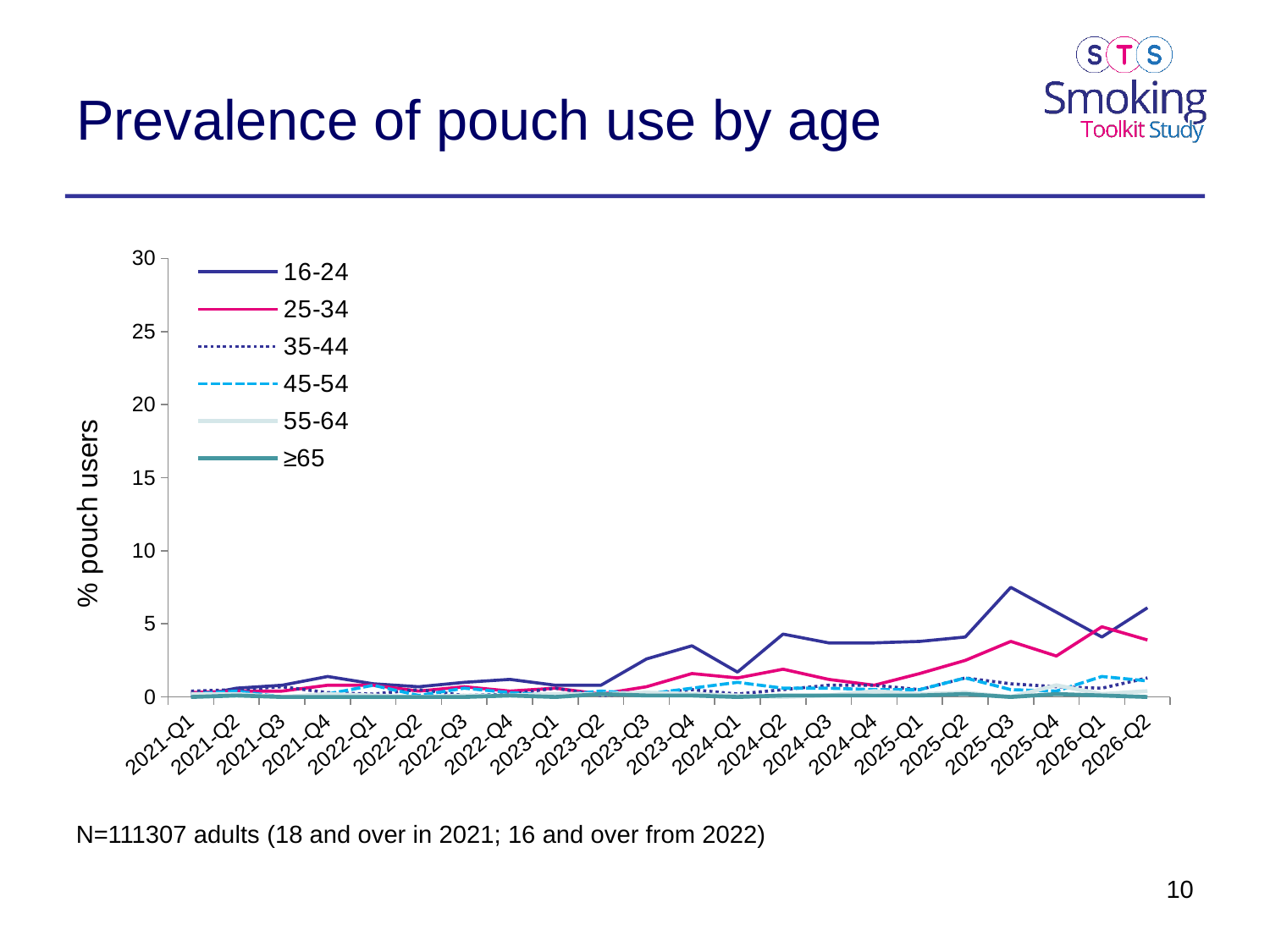
Is the value for the 16-24 age group at 2025-Q3 greater or less than 5? greater At 2025-Q3, which is larger: the value for 16-24 or the value for 25-34? 16-24 How many age groups does the legend list? 6 Does the value for the 16-24 age group generally rise or fall from 2021-Q1 to 2026-Q2? rise What is the title of the chart? Prevalence of pouch use by age How many quarterly time points are shown on the x axis? 22 Is the value for the 16-24 age group at 2021-Q1 greater or less than 5? less Which age group has the highest value at 2025-Q3? 16-24 What kind of chart is shown on the slide? line chart What is the label on the y axis? % pouch users Which age group has the highest value at 2026-Q2? 16-24 Is the value for the 25-34 age group at 2025-Q3 greater or less than 5? less